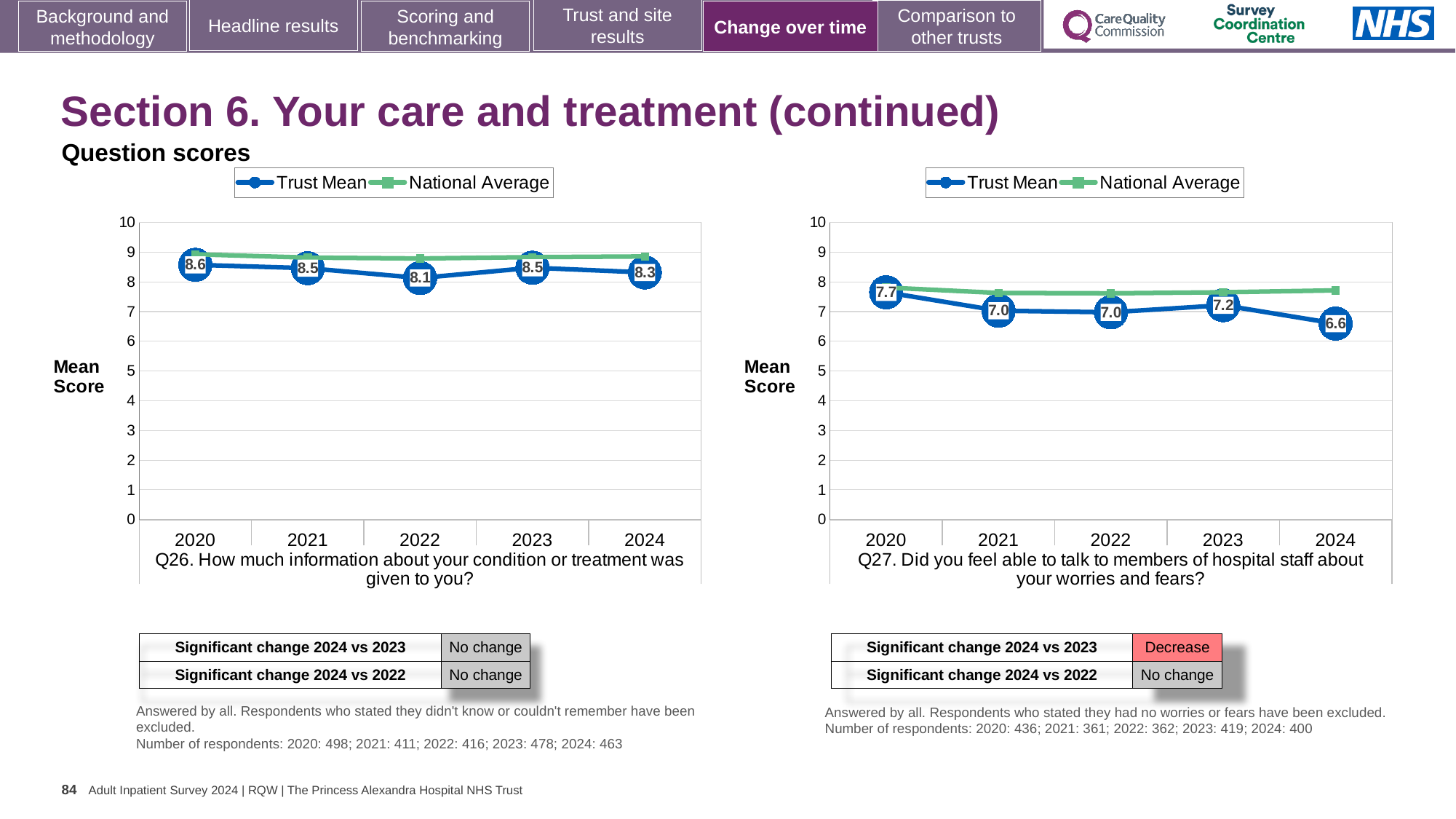
In the Q26 chart (left), which year has the highest Trust Mean score? 2020 In the Q26 chart (left), what is the Trust Mean score for 2022? 8.1 In the Q27 chart (right), does the Trust Mean score rise or fall from 2023 to 2024? Fall In the Q27 chart (right), which year has the lowest Trust Mean score? 2024 How many series does the legend of the Q27 chart (right) list? 2 In the Q27 chart (right), what is the difference between the Trust Mean scores for 2020 and 2024? 1.1 How many years are plotted on the x axis of the Q26 chart (left)? 5 In the Q26 chart (left), is the Trust Mean score higher in 2021 or in 2022? 2021 What type of chart is used for Q26 (left)? Line chart In the Q27 chart (right), what is the Trust Mean score for 2024? 6.6 In the Q27 chart (right), is the National Average value for 2024 greater or less than 7? greater In the Q26 chart (left), what is the difference between the Trust Mean scores for 2020 and 2022? 0.5